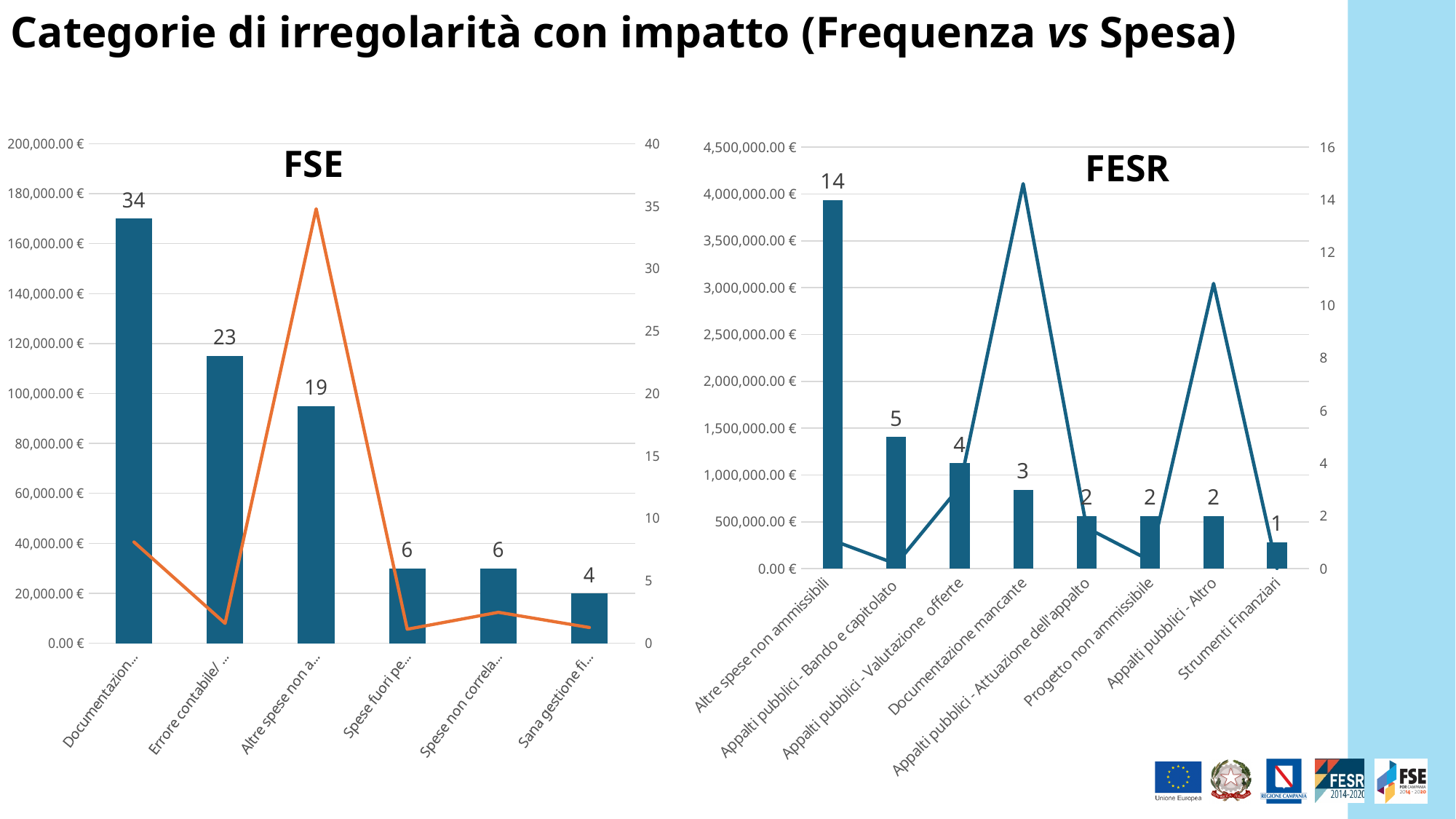
In the FESR chart, what is the difference between the bar values for Altre spese non ammissibili and Appalti pubblici - Bando e capitolato? 9 In the FESR chart, is the line value for Appalti pubblici - Altro greater or less than 2,500,000.00 €? greater In the FESR chart, which category has the lowest bar? Strumenti Finanziari In the FSE chart, is the line value for 'Altre spese non a...' greater or less than 160,000.00 €? greater In the FESR chart, what is the value shown on the bar for Altre spese non ammissibili? 14 In the FSE chart, how many categories are shown on the x axis? 6 In the FESR chart, how many categories are shown on the x axis? 8 In the FESR chart, which category has the highest bar? Altre spese non ammissibili In the FSE chart, what is the value shown on the tallest bar? 34 How many charts are shown on the slide? 2 In the FESR chart, is the line value for Documentazione mancante greater or less than 3,500,000.00 €? greater In the FESR chart, what is the value shown on the bar for Documentazione mancante? 3